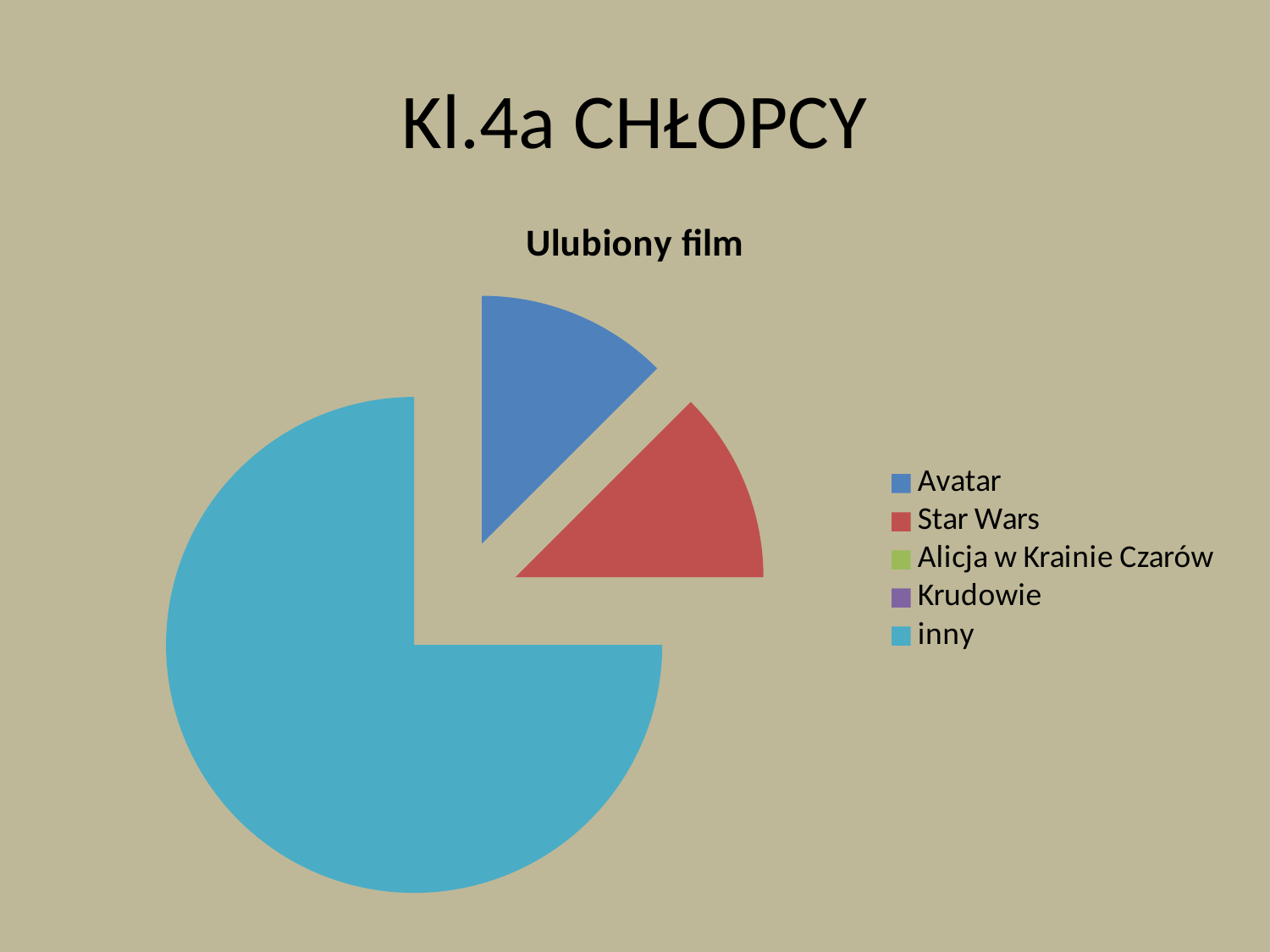
What kind of chart is shown on the slide? pie chart Which slice is larger, inny or Star Wars? inny Which slice is larger, inny or Avatar? inny Which legend entry is shown in red? Star Wars How many entries does the chart's legend list? 5 Which category has the largest slice of the pie? inny What is the title of the chart? Ulubiony film